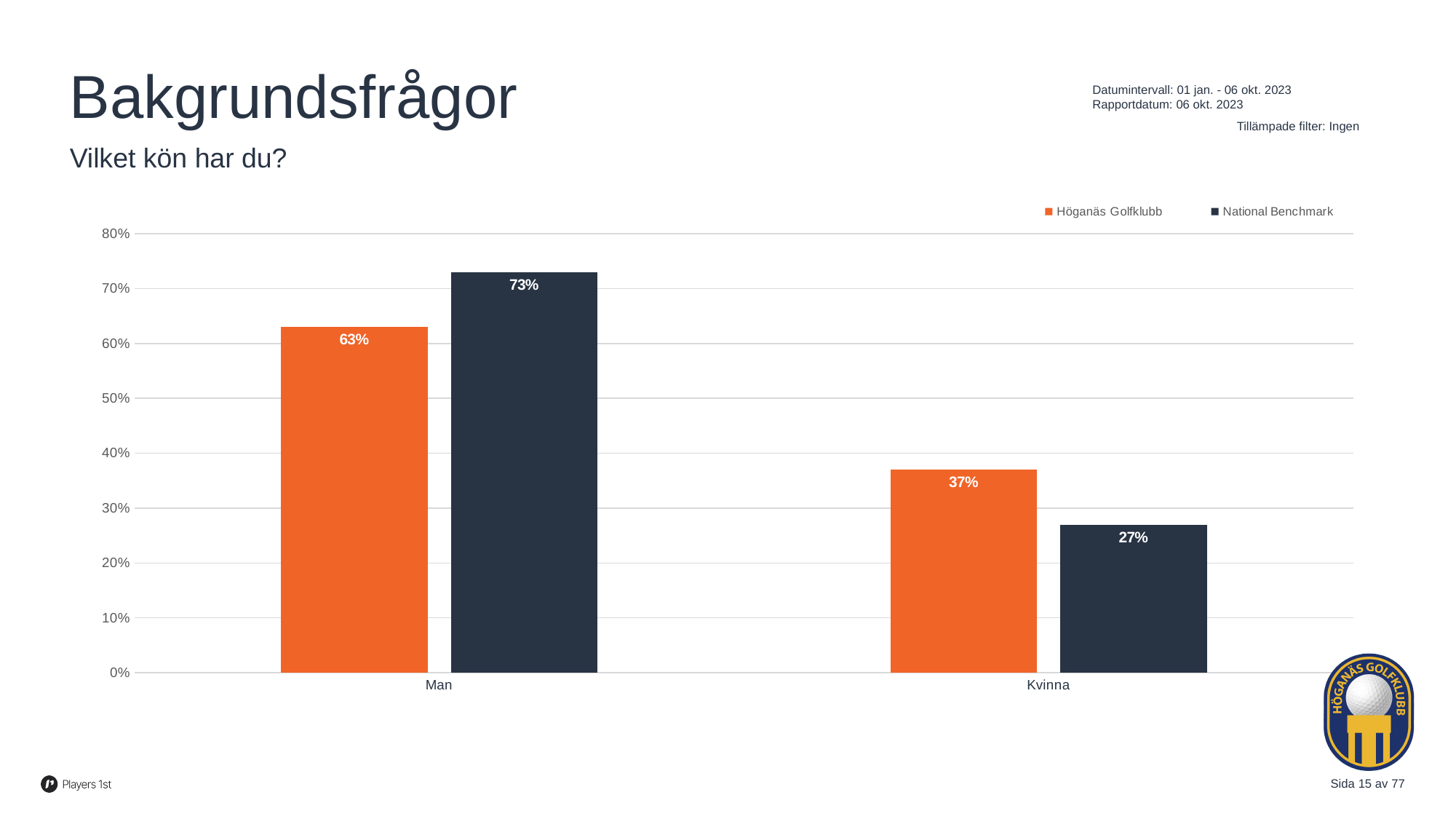
Which category has the highest National Benchmark value? Man How many series does the legend list? 2 What is the value for Höganäs Golfklubb in the Man category? 63% Which is larger for Kvinna: Höganäs Golfklubb or National Benchmark? Höganäs Golfklubb What is the value for National Benchmark in the Man category? 73% What is the value for National Benchmark in the Kvinna category? 27% How many categories are shown on the x axis? 2 Which category has the lowest Höganäs Golfklubb value? Kvinna What is the difference between the National Benchmark and Höganäs Golfklubb values for Man? 10% What is the value for Höganäs Golfklubb in the Kvinna category? 37% What kind of chart is shown on the slide? Bar chart Is the Höganäs Golfklubb value for Man greater or less than 60%? greater